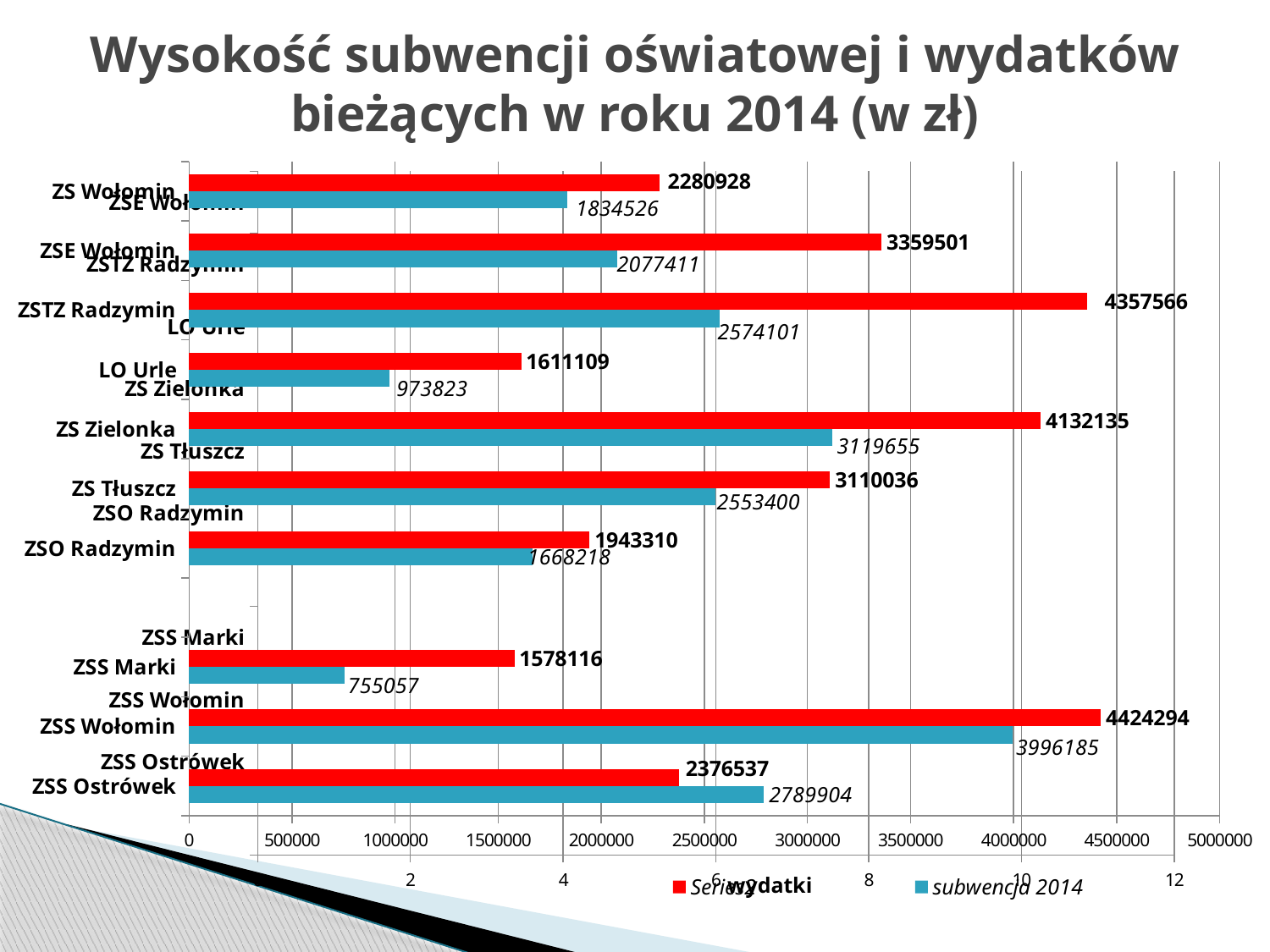
What is the wydatki value for ZSTZ Radzymin? 4357566 What is the difference between the subwencja 2014 and wydatki values for ZSS Ostrówek? 413367 How many schools are shown on the chart? 10 What is the difference between the wydatki and subwencja 2014 values for ZS Wołomin? 446402 What is the subwencja 2014 value for LO Urle? 973823 What type of chart is shown on the slide? bar chart How many data series does the chart show? 2 Which school has the highest wydatki value? ZSS Wołomin For ZSS Ostrówek, which is larger: wydatki or subwencja 2014? subwencja 2014 Is the wydatki value for ZS Zielonka greater or less than 4000000? greater Which school has the lowest subwencja 2014 value? ZSS Marki What is the subwencja 2014 value for ZSS Ostrówek? 2789904